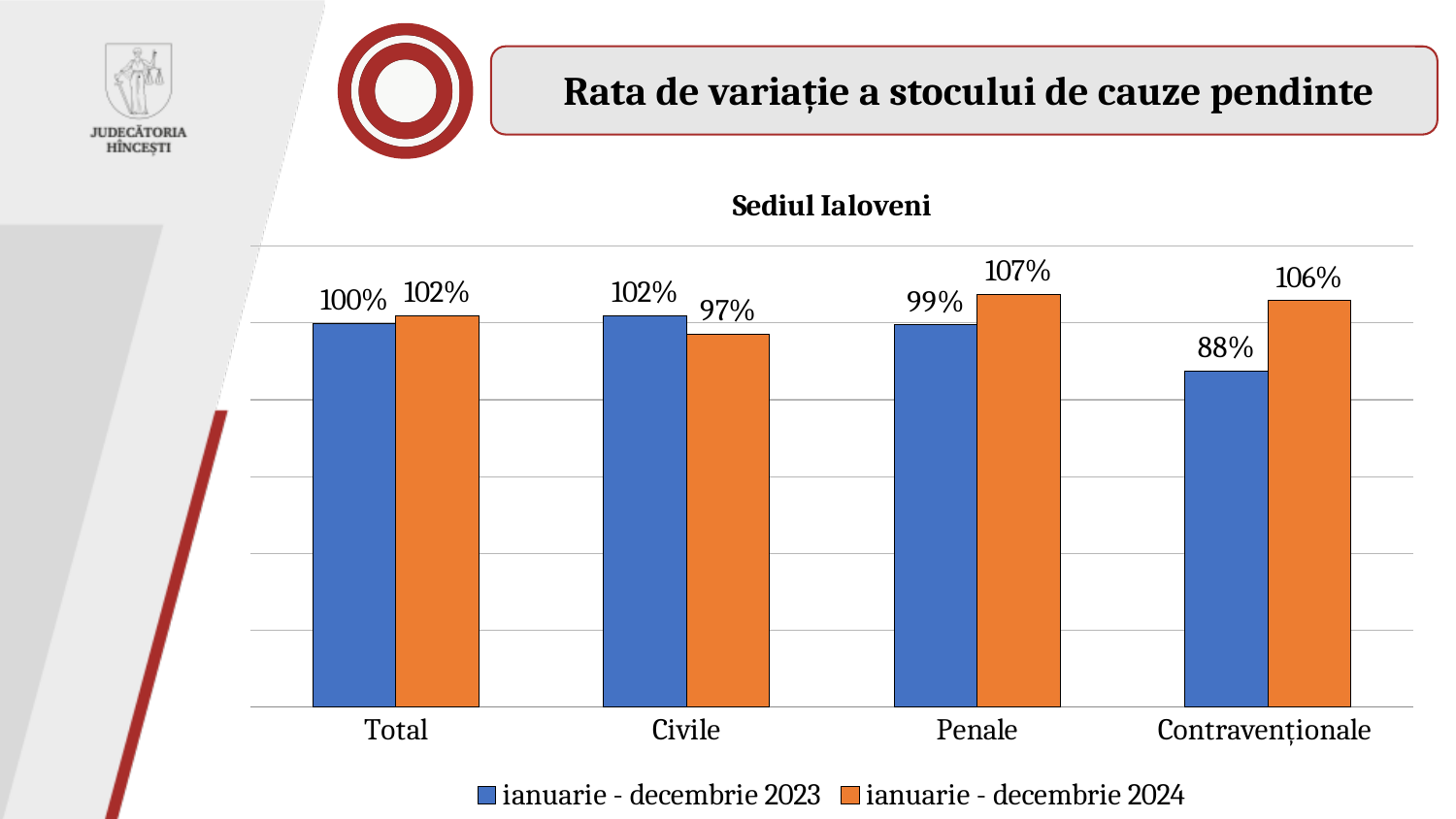
How many categories are shown on the x axis? 4 Which category has the lowest value in the ianuarie - decembrie 2023 series? Contravenționale Which category has the highest value in the ianuarie - decembrie 2024 series? Penale What is the title of the chart? Sediul Ialoveni What kind of chart is shown on the slide? Bar chart For Civile, which series has the larger value: ianuarie - decembrie 2023 or ianuarie - decembrie 2024? ianuarie - decembrie 2023 What is the difference between the ianuarie - decembrie 2024 and ianuarie - decembrie 2023 values for Contravenționale? 18% What is the value for Total in the ianuarie - decembrie 2023 series? 100% What is the value for Contravenționale in the ianuarie - decembrie 2023 series? 88% What is the value for Civile in the ianuarie - decembrie 2024 series? 97% What is the value for Penale in the ianuarie - decembrie 2024 series? 107% How many series does the legend list? 2